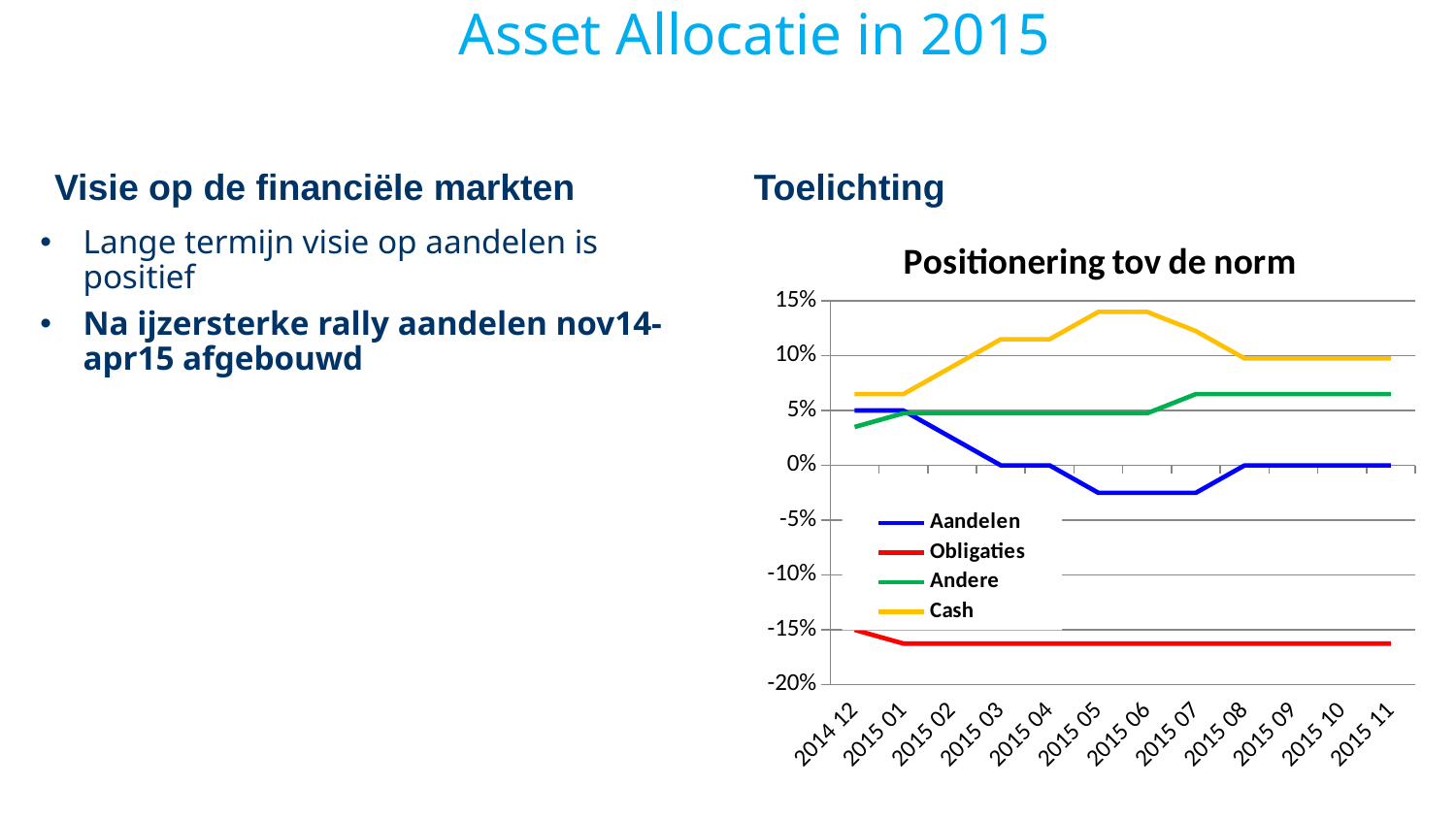
At 2015 06, which is larger: the value for Cash or the value for Aandelen? Cash What is the value for Aandelen at 2015 03? 0% How many series does the legend of the chart list? 4 What is the value for Obligaties at 2014 12? -15% Which series has the highest value at 2015 05? Cash Is the value for Obligaties at 2015 06 greater or less than -15%? less What kind of chart is shown on the slide? line chart Which series has the lowest value at 2015 11? Obligaties Is the value for Cash at 2015 05 greater or less than 10%? greater How many time points are shown on the x axis of the chart? 12 Does the Aandelen line rise or fall from 2015 01 to 2015 05? fall